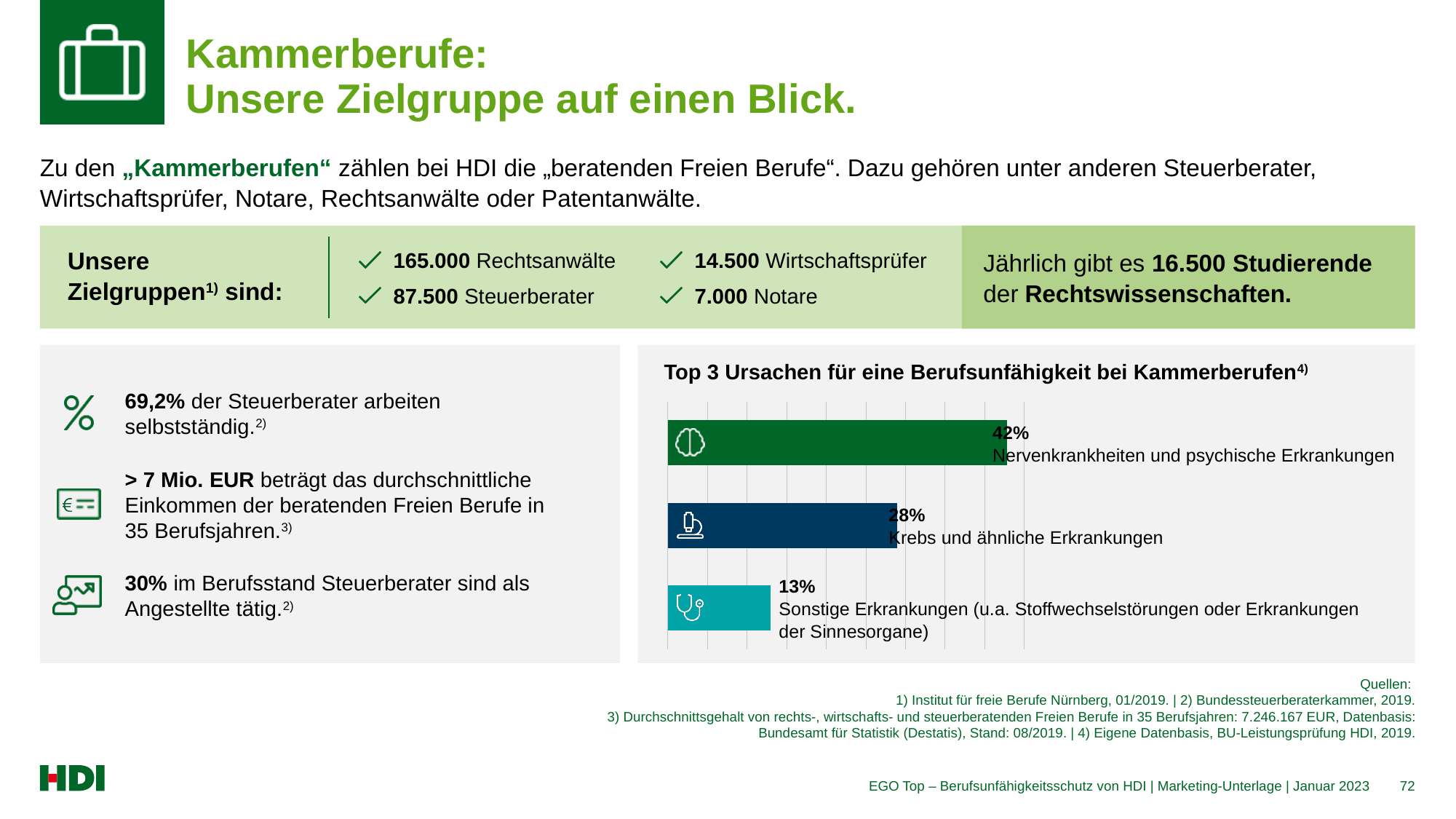
What is the difference between the values for Nervenkrankheiten und psychische Erkrankungen and Krebs und ähnliche Erkrankungen? 14% Which cause has the highest value in the chart? Nervenkrankheiten und psychische Erkrankungen What is the title of the chart? Top 3 Ursachen für eine Berufsunfähigkeit bei Kammerberufen What kind of chart is shown on the slide? Bar chart What is the value for Sonstige Erkrankungen in the chart? 13% What colour is the bar for Sonstige Erkrankungen? Teal What is the value for Nervenkrankheiten und psychische Erkrankungen in the chart? 42% Which cause has the lowest value in the chart? Sonstige Erkrankungen How many causes are shown in the chart? 3 What is the value for Krebs und ähnliche Erkrankungen in the chart? 28% What is the difference between the values for Krebs und ähnliche Erkrankungen and Sonstige Erkrankungen? 15% Which is larger: the value for Krebs und ähnliche Erkrankungen or the value for Sonstige Erkrankungen? Krebs und ähnliche Erkrankungen